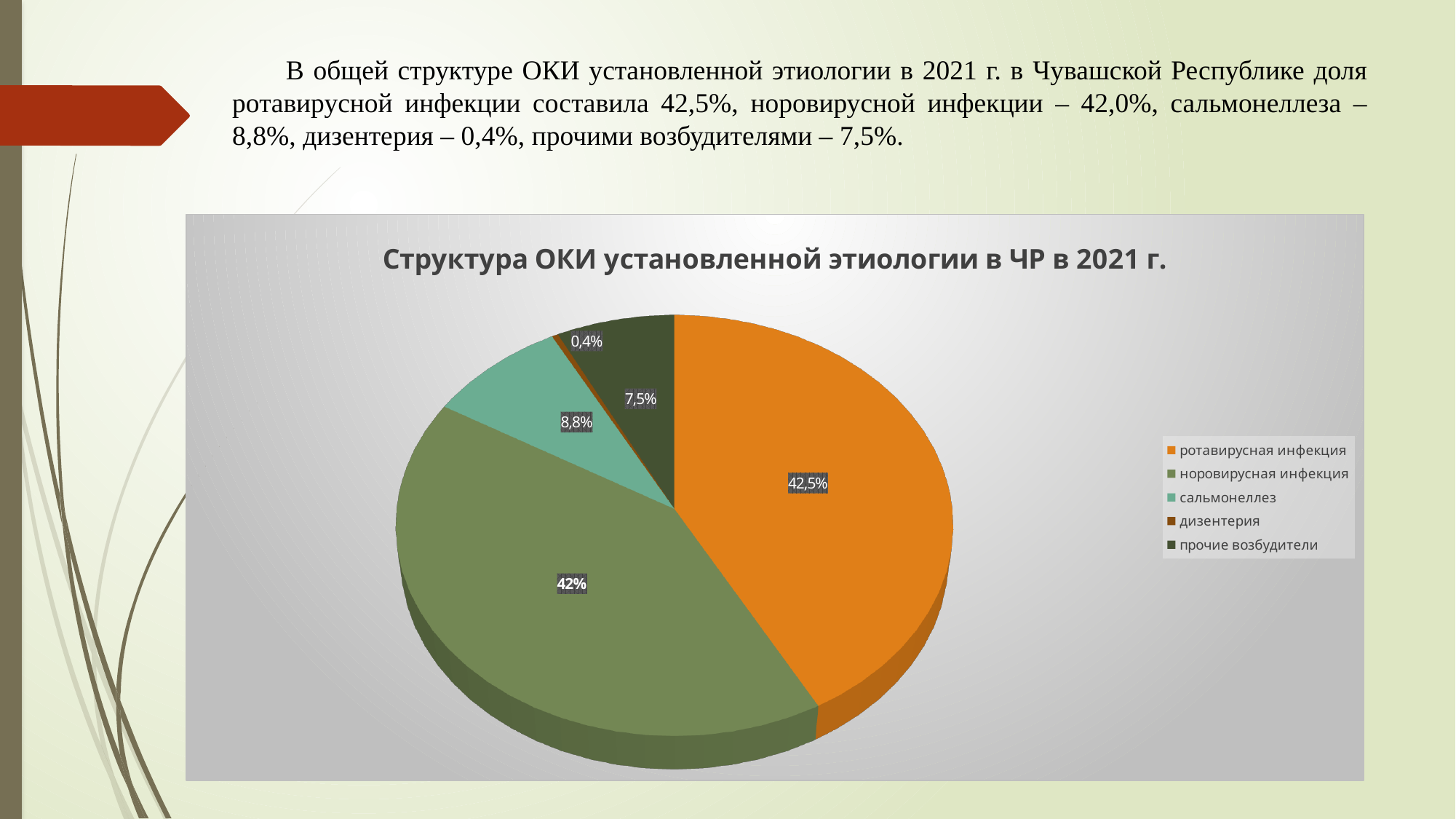
Which is larger: the share of сальмонеллез or the share of прочие возбудители? сальмонеллез What is the title of the chart? Структура ОКИ установленной этиологии в ЧР в 2021 г. What type of chart is shown on the slide? pie chart What share of the pie is сальмонеллез? 8,8% What is the difference between the shares of сальмонеллез and прочие возбудители? 1,3% What share of the pie is норовирусная инфекция? 42% How many categories does the pie chart show? 5 Which category has the smallest share of the pie? дизентерия What share of the pie is прочие возбудители? 7,5% What share of the pie is дизентерия? 0,4% Which category has the largest share of the pie? ротавирусная инфекция What share of the pie is ротавирусная инфекция? 42,5%